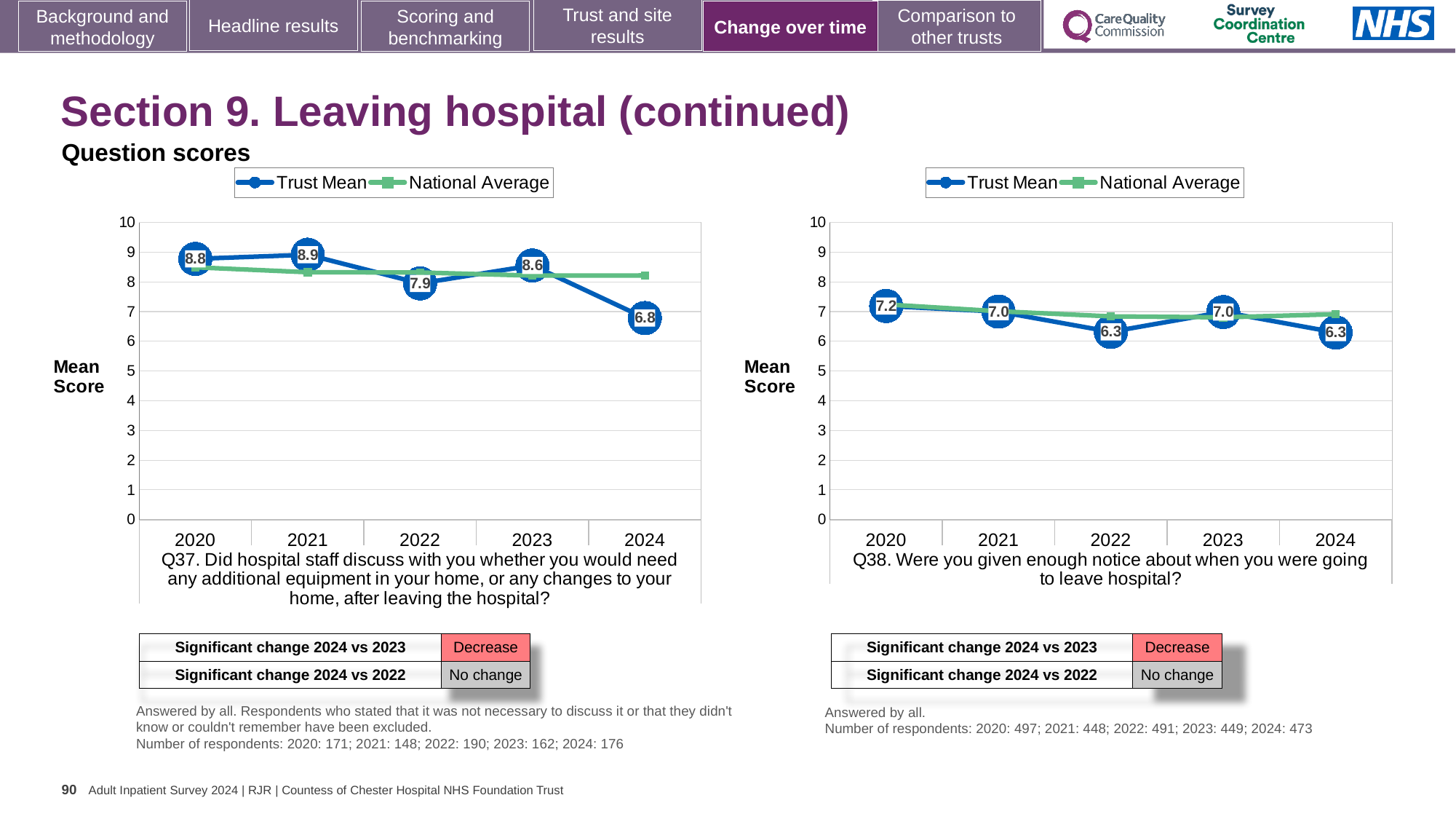
In the Q38 chart (right), is the Trust Mean for 2020 larger or smaller than the Trust Mean for 2024? larger In the Q38 chart (right), which year has the highest Trust Mean score? 2020 In the Q37 chart (left), which year has the lowest Trust Mean score? 2024 In the Q38 chart (right), what is the Trust Mean score for 2020? 7.2 In the Q37 chart (left), what is the Trust Mean score for 2021? 8.9 In the Q37 chart (left), what is the difference between the Trust Mean scores for 2023 and 2024? 1.8 In the Q38 chart (right), what is the Trust Mean score for 2022? 6.3 In the Q37 chart (left), what is the Trust Mean score for 2024? 6.8 In the Q37 chart (left), which year has the highest Trust Mean score? 2021 How many series does the legend of the Q37 chart (left) list? 2 In the Q37 chart (left), is the National Average for 2024 greater or less than 7? greater How many years are plotted on the x axis of the Q38 chart (right)? 5